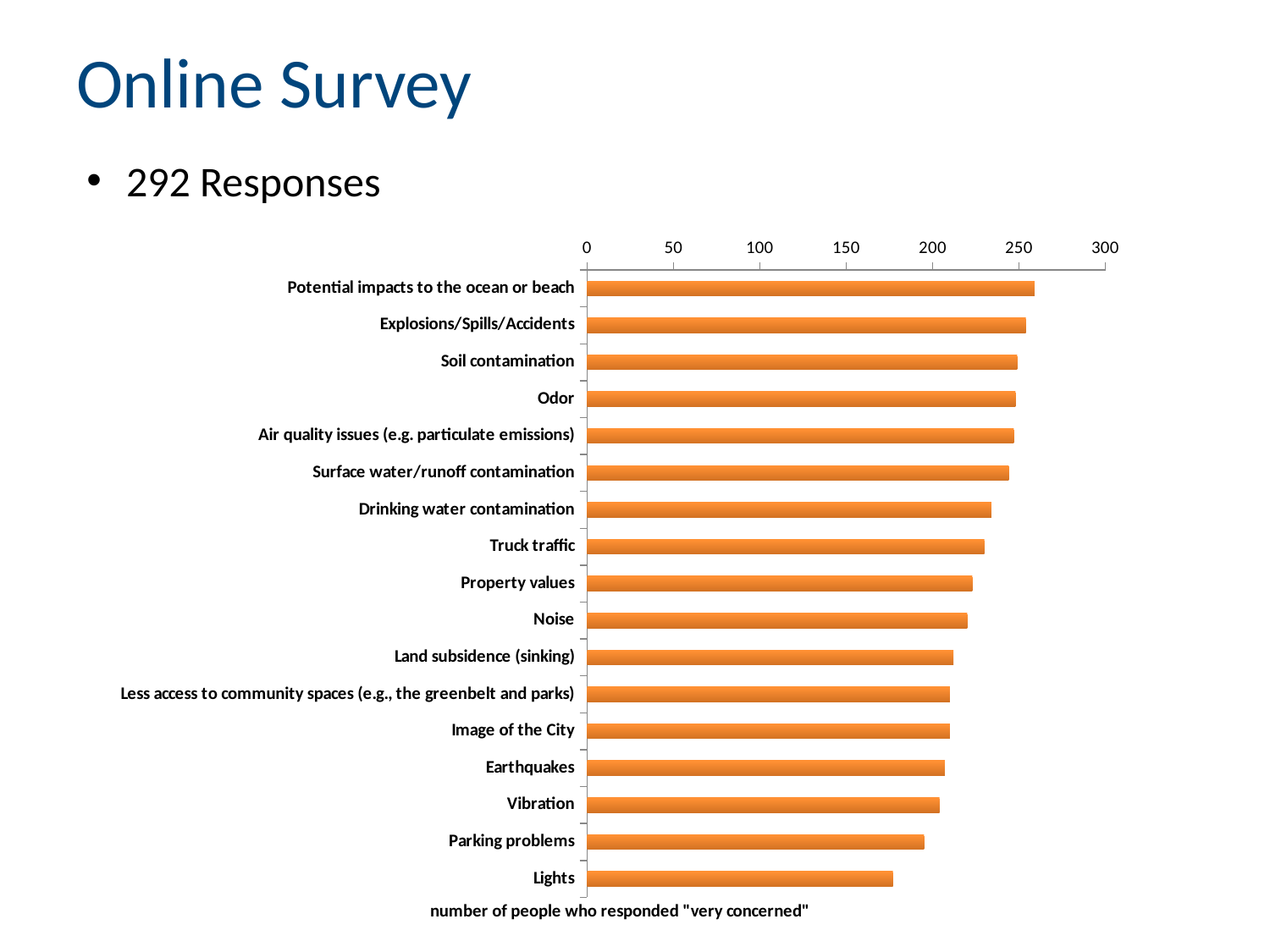
Which concern has the highest number of people who responded "very concerned"? Potential impacts to the ocean or beach What does the axis label below the chart say the bars represent? number of people who responded "very concerned" Which has a larger value, Parking problems or Soil contamination? Soil contamination Is the value for Drinking water contamination greater or less than 200? greater What kind of chart is shown on the slide? bar chart Is the value for Noise greater or less than 250? less Which concern has the lowest number of people who responded "very concerned"? Lights How many categories (concerns) are plotted in the chart? 17 Which has a larger value, Truck traffic or Lights? Truck traffic Is the value for Potential impacts to the ocean or beach greater or less than 250? greater